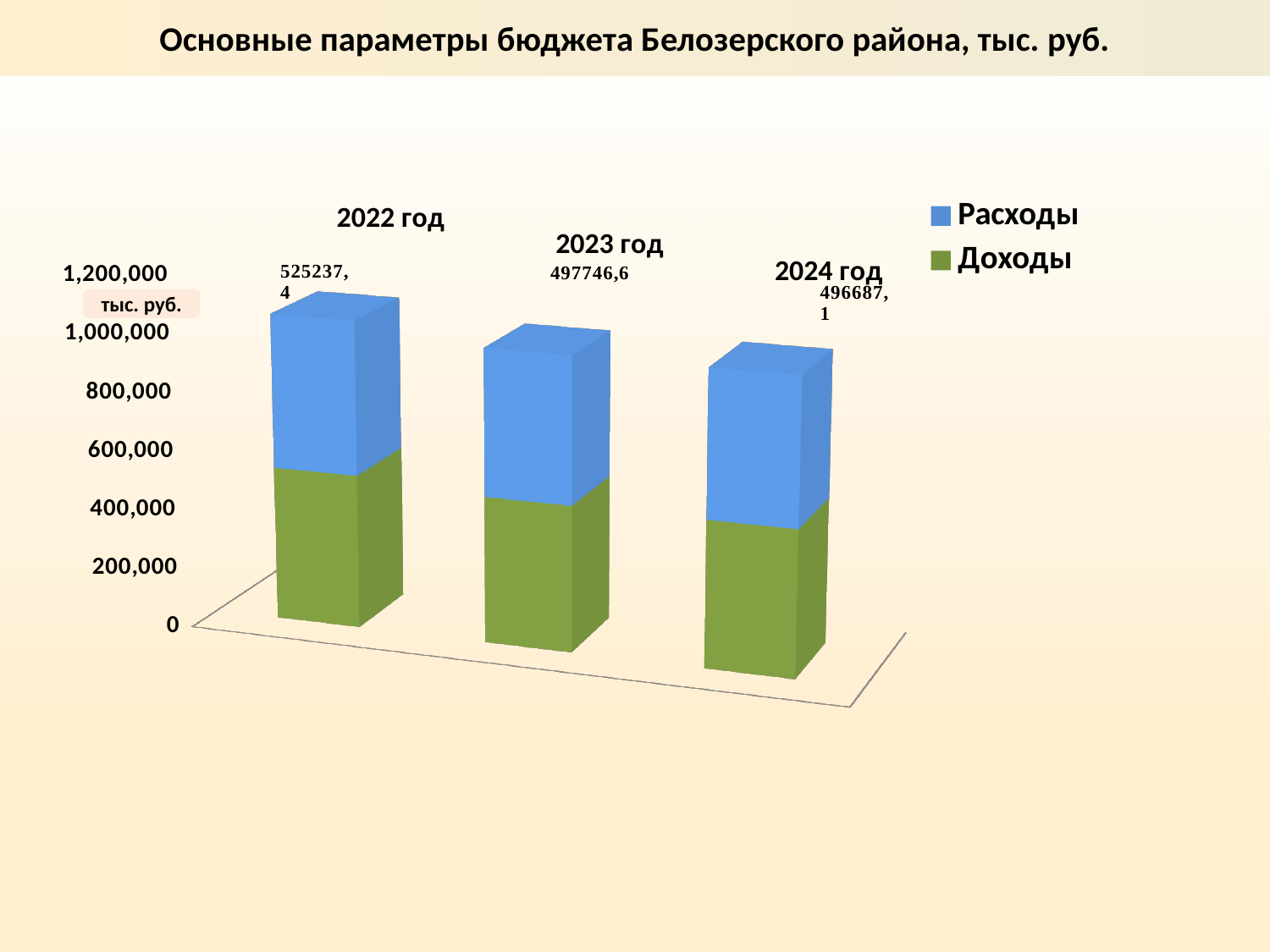
Which colour represents Доходы in the legend? green Which year has the highest printed value? 2022 год How many series does the legend list? 2 What kind of chart is shown on the slide? bar chart What value is printed above the bar for 2024 год? 496687,1 What value is printed above the bar for 2022 год? 525237,4 What value is printed above the bar for 2023 год? 497746,6 How many years (categories) are shown in the chart? 3 Do the printed values rise or fall from 2022 год to 2024 год? fall Which year has the lowest printed value? 2024 год Which printed value is larger, 2023 год or 2024 год? 2023 год What is the difference between the printed values for 2022 год and 2023 год? 27490,8